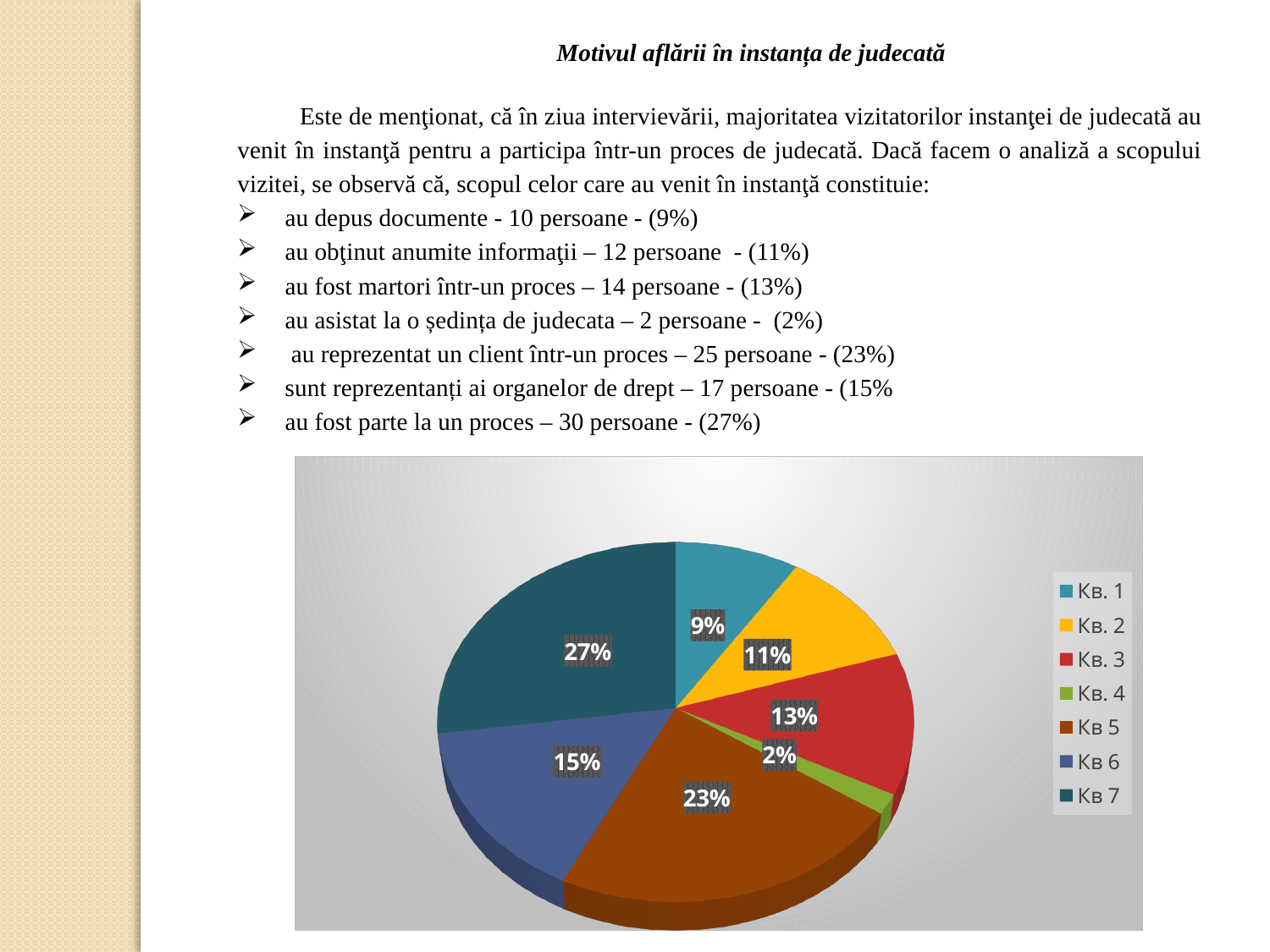
What is the difference in percentage points between the slices for Кв 7 and Кв 5? 4 What share of the pie does the slice for Кв. 1 represent? 9% What kind of chart is shown on the slide? pie chart What share of the pie does the slice for Кв 5 represent? 23% How many entries does the legend of the pie chart list? 7 What share of the pie does the slice for Кв 6 represent? 15% How many slices does the pie chart have? 7 Which legend entry corresponds to the smallest slice of the pie? Кв. 4 Which legend entry corresponds to the largest slice of the pie? Кв 7 Which slice is larger, Кв 6 or Кв. 3? Кв 6